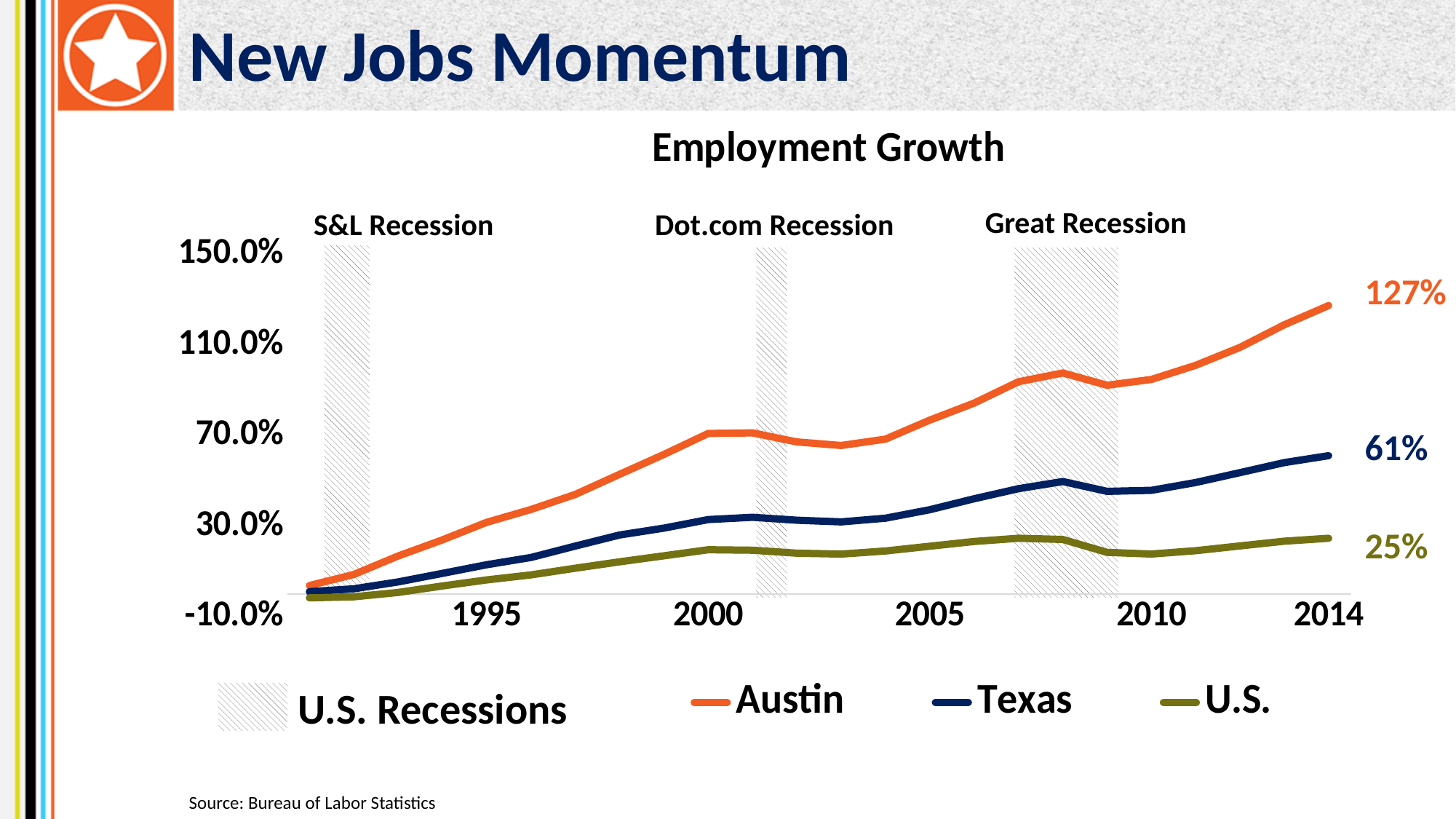
What is the employment growth value for U.S. in 2014? 25% What is the employment growth value for Texas in 2014? 61% What is the employment growth value for Austin in 2014? 127% Which series has the highest employment growth in 2014? Austin How many line series are plotted on the chart? 3 What kind of chart is shown on the slide? line chart Does the Austin line generally rise or fall from the start of the chart to 2014? rise Is the value for Austin in 2000 greater or less than 30.0%? greater Is the value for Texas in 2000 greater or less than 70.0%? less Which series has the lowest employment growth in 2014? U.S. What is the difference between the Austin and Texas employment growth values in 2014? 66% Which is larger in 2014, the Texas value or the U.S. value? Texas